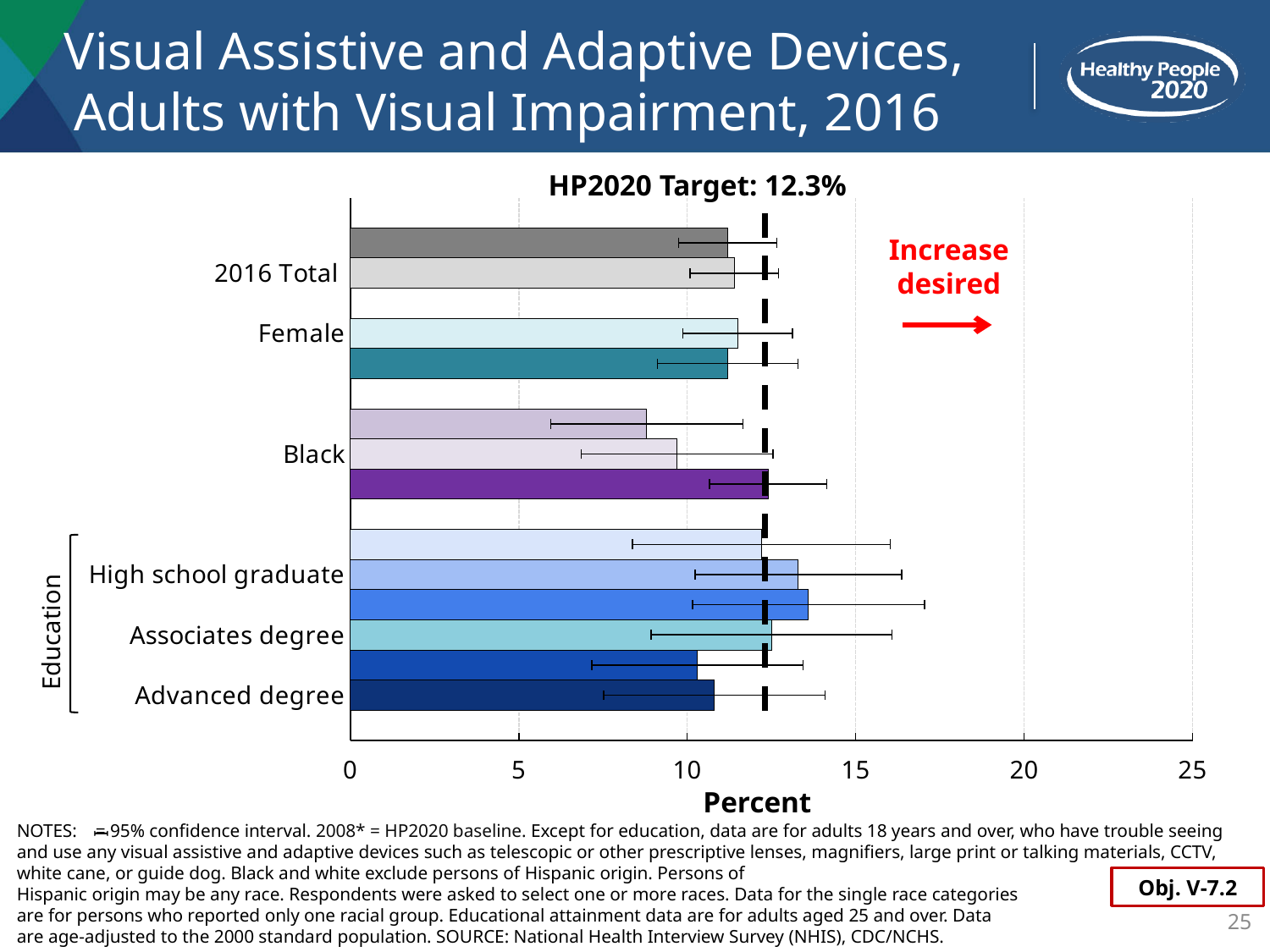
How many category labels are shown on the y axis of the chart? 6 Is the value for Advanced degree greater or less than 15? less Is the value for Black greater or less than 15? less Which has the larger value, High school graduate or Advanced degree? High school graduate What is the title of the x axis? Percent Is the value for High school graduate greater or less than 10? greater What is the HP2020 Target value printed above the chart? 12.3% What kind of chart is shown on the slide? bar chart Which has the larger value, Black or High school graduate? High school graduate